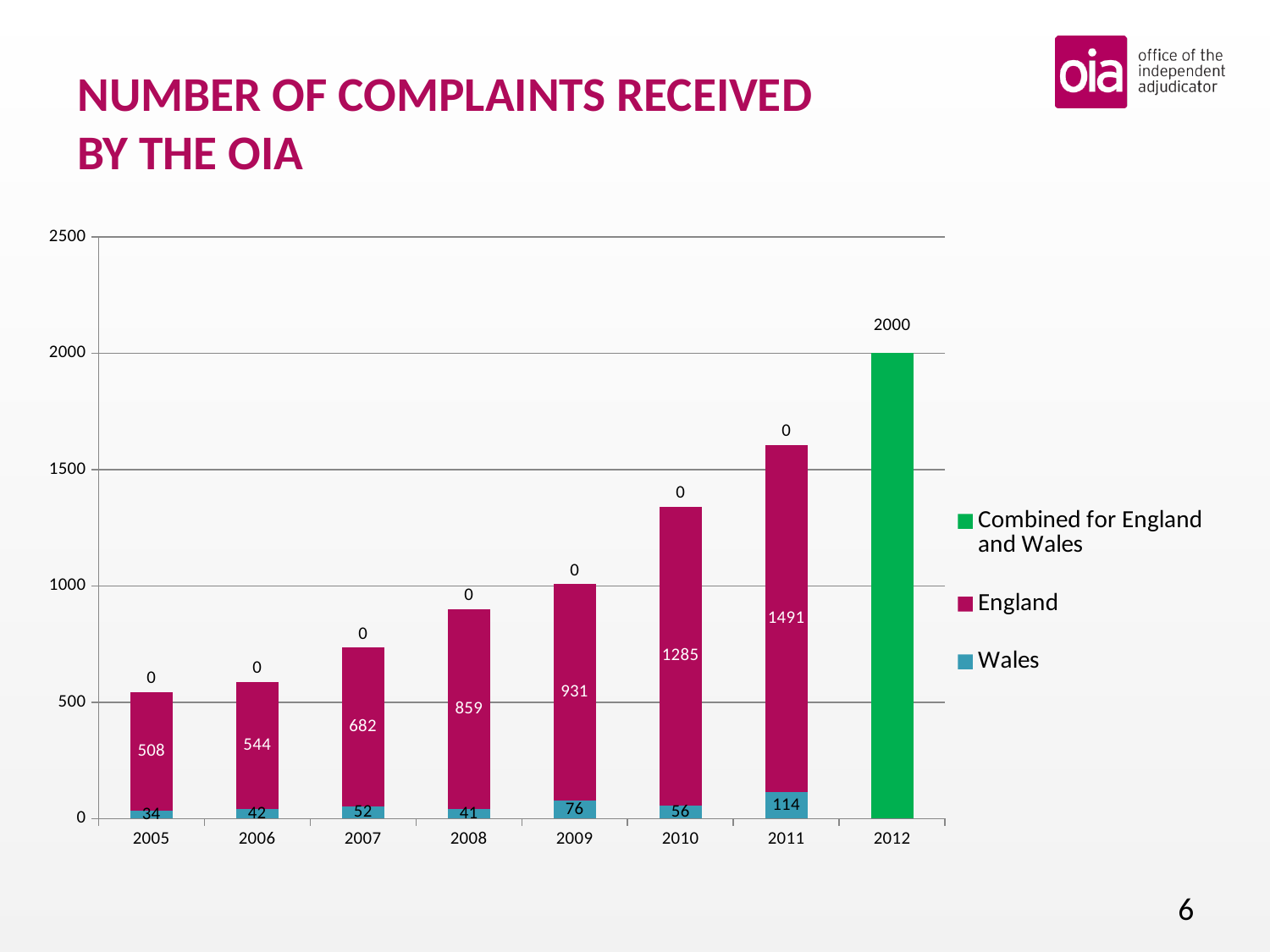
What is the value for Wales in 2011? 114 In which year is the England value lowest? 2005 Do the England values rise or fall from 2005 to 2011? Rise In which year is the Wales value highest? 2011 What kind of chart is shown on the slide? Stacked bar chart How many series does the legend list? 3 Which is larger, the Wales value for 2009 or for 2010? 2009 How many years are shown on the x axis? 8 What is the value for Combined for England and Wales in 2012? 2000 What is the total of the stacked bar for 2011? 1605 What is the value for England in 2009? 931 What is the difference between the England values for 2011 and 2010? 206